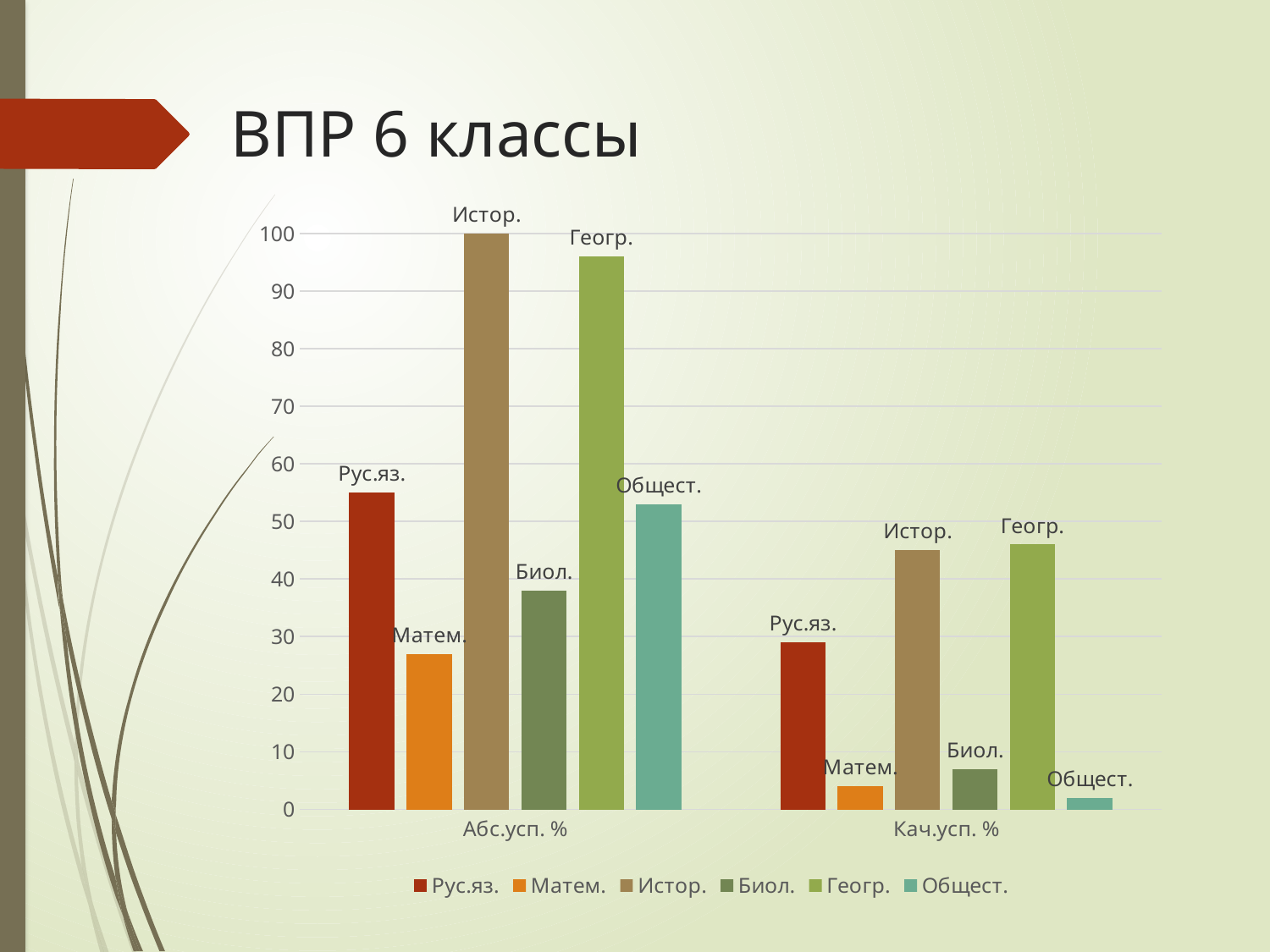
Which subject has the lowest value in the Абс.усп. % category? Матем. Is the value for Рус.яз. in the Абс.усп. % category greater or less than 50? greater What kind of chart is shown on the slide? bar chart How many series does the legend list? 6 Is the value for Матем. in the Кач.усп. % category greater or less than 10? less For Истор., which category has the larger value: Абс.усп. % or Кач.усп. %? Абс.усп. % How many categories are shown on the x axis? 2 What is the value for Истор. in the Абс.усп. % category? 100 Which subject has the highest value in the Абс.усп. % category? Истор. In the Абс.усп. % category, which is larger: Рус.яз. or Биол.? Рус.яз. Which subject has the lowest value in the Кач.усп. % category? Общест. What is the title of the slide? ВПР 6 классы